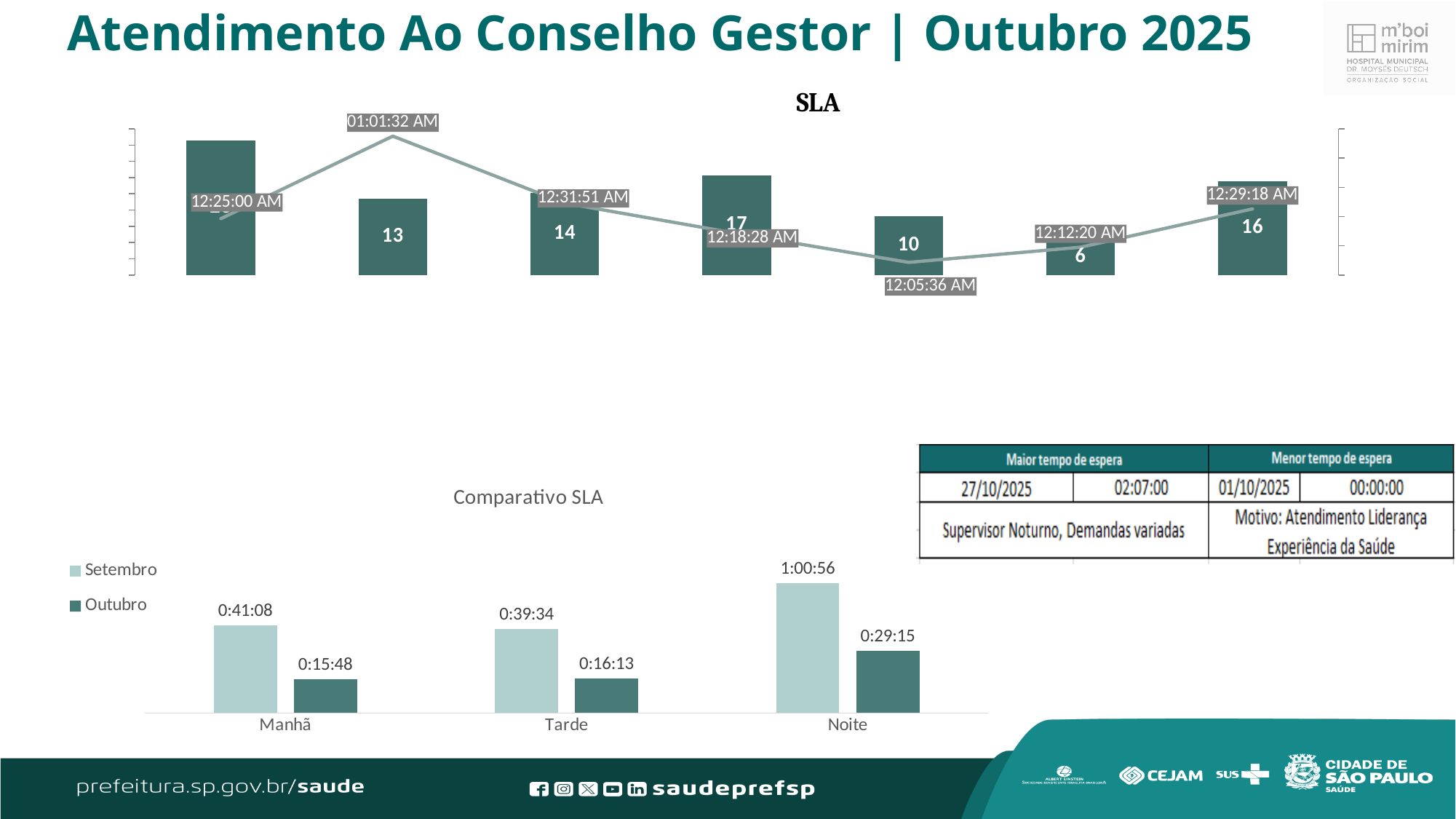
In the Comparativo SLA chart, what is the Outubro value for Noite? 0:29:15 What kind of chart is the Comparativo SLA chart? bar chart In the Comparativo SLA chart, which category has the lowest Outubro value? Manhã How many series does the legend of the Comparativo SLA chart list? 2 In the SLA chart at the top, how many bars are plotted? 7 In the Comparativo SLA chart, which category has the highest Setembro value? Noite In the Comparativo SLA chart, what is the difference between the Setembro and Outubro values for Manhã? 0:25:20 In the Comparativo SLA chart, which is larger for Tarde: Setembro or Outubro? Setembro In the Comparativo SLA chart, what is the Outubro value for Tarde? 0:16:13 In the SLA chart at the top, what is the highest value labelled on the line? 01:01:32 AM In the Comparativo SLA chart, what is the Setembro value for Manhã? 0:41:08 In the Comparativo SLA chart, what is the Setembro value for Noite? 1:00:56